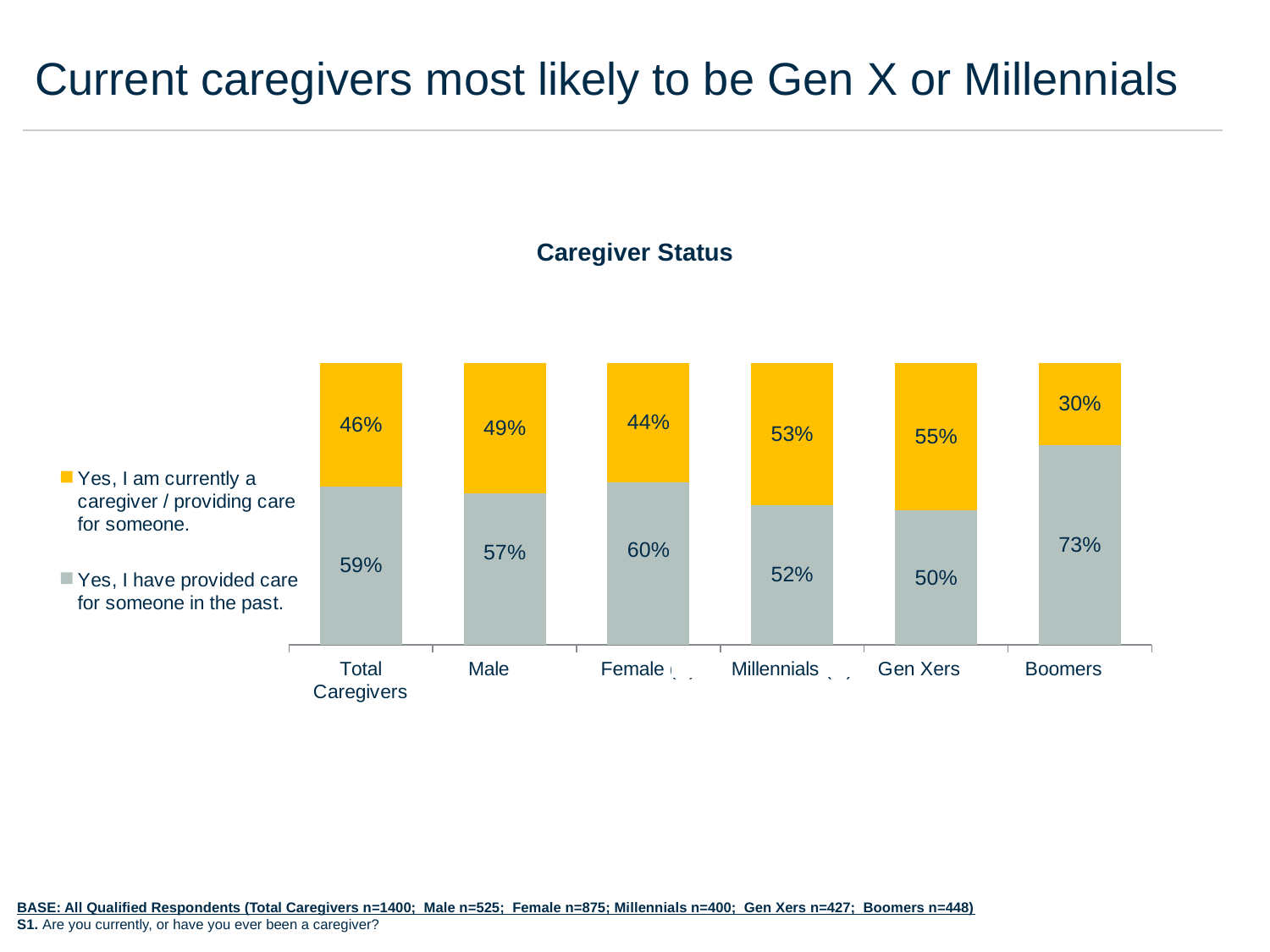
What is the value for Total Caregivers in the 'Yes, I have provided care for someone in the past' series? 59% What percentage of Boomers say they have provided care for someone in the past? 73% Which category has the lowest share of current caregivers? Boomers What percentage of Gen Xers say they are currently a caregiver / providing care for someone? 55% Which is larger, the share of Male or Female respondents who are currently a caregiver? Male How many categories are shown on the x axis? 6 How many series does the legend list? 2 Which category has the highest share of current caregivers? Gen Xers What type of chart is shown on the slide? Stacked bar chart Which category has the highest share of people who have provided care in the past? Boomers What is the difference between the Gen Xers and Boomers values for currently being a caregiver? 25 percentage points What is the value for Female in the 'Yes, I am currently a caregiver / providing care for someone' series? 44%